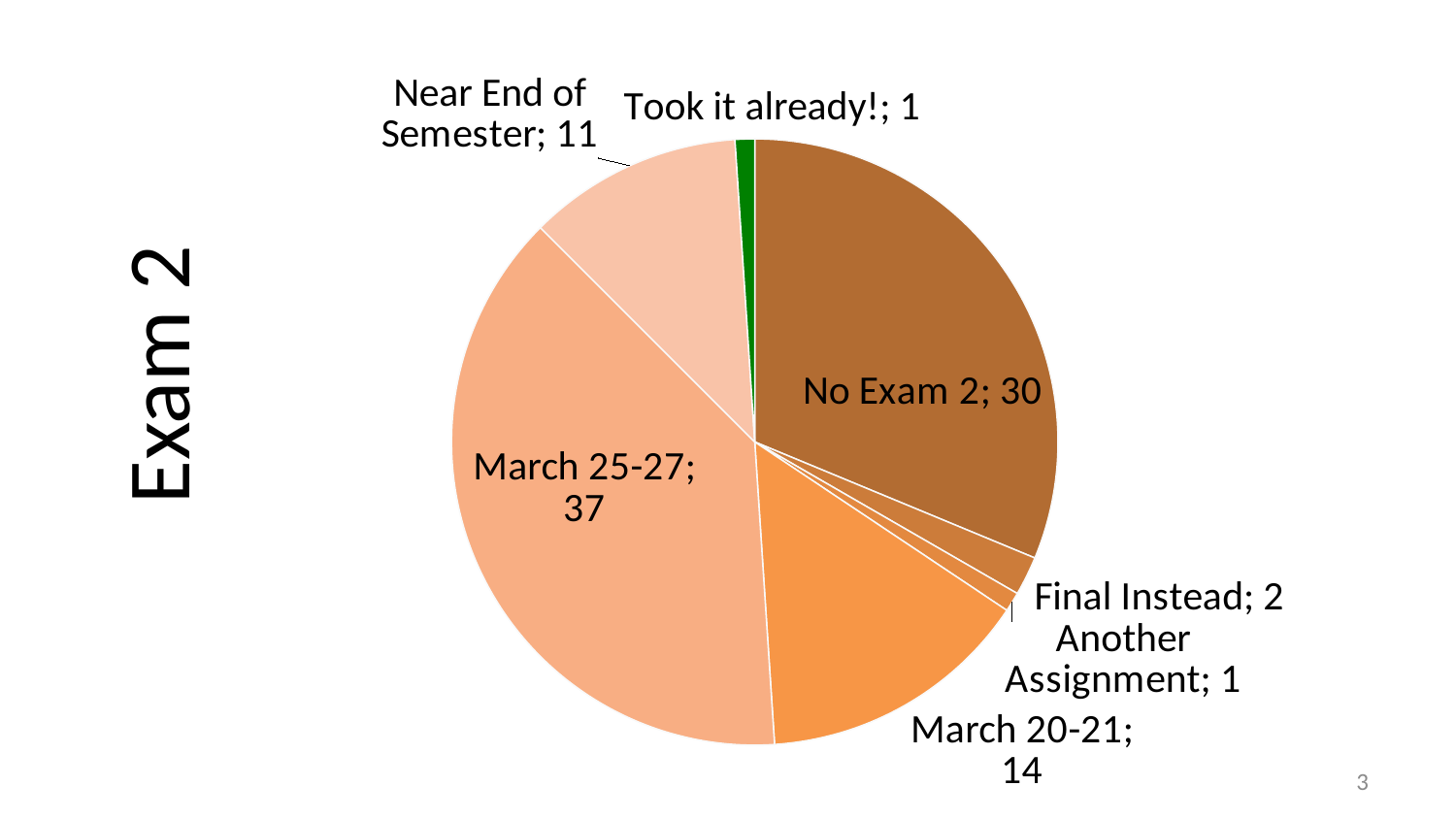
How many slices does the pie chart have? 7 What is the title of the slide containing the pie chart? Exam 2 What is the value for the "March 20-21" slice? 14 What is the value for the "Near End of Semester" slice? 11 Which slice has the largest value? March 25-27 What is the value for the "Final Instead" slice? 2 What is the value for the "No Exam 2" slice? 30 What type of chart is shown on the slide? pie chart How many slices have a value of 1? 2 What is the difference between the "March 25-27" value and the "No Exam 2" value? 7 Which is larger, the value for "March 20-21" or the value for "Near End of Semester"? March 20-21 What is the value for the "March 25-27" slice? 37